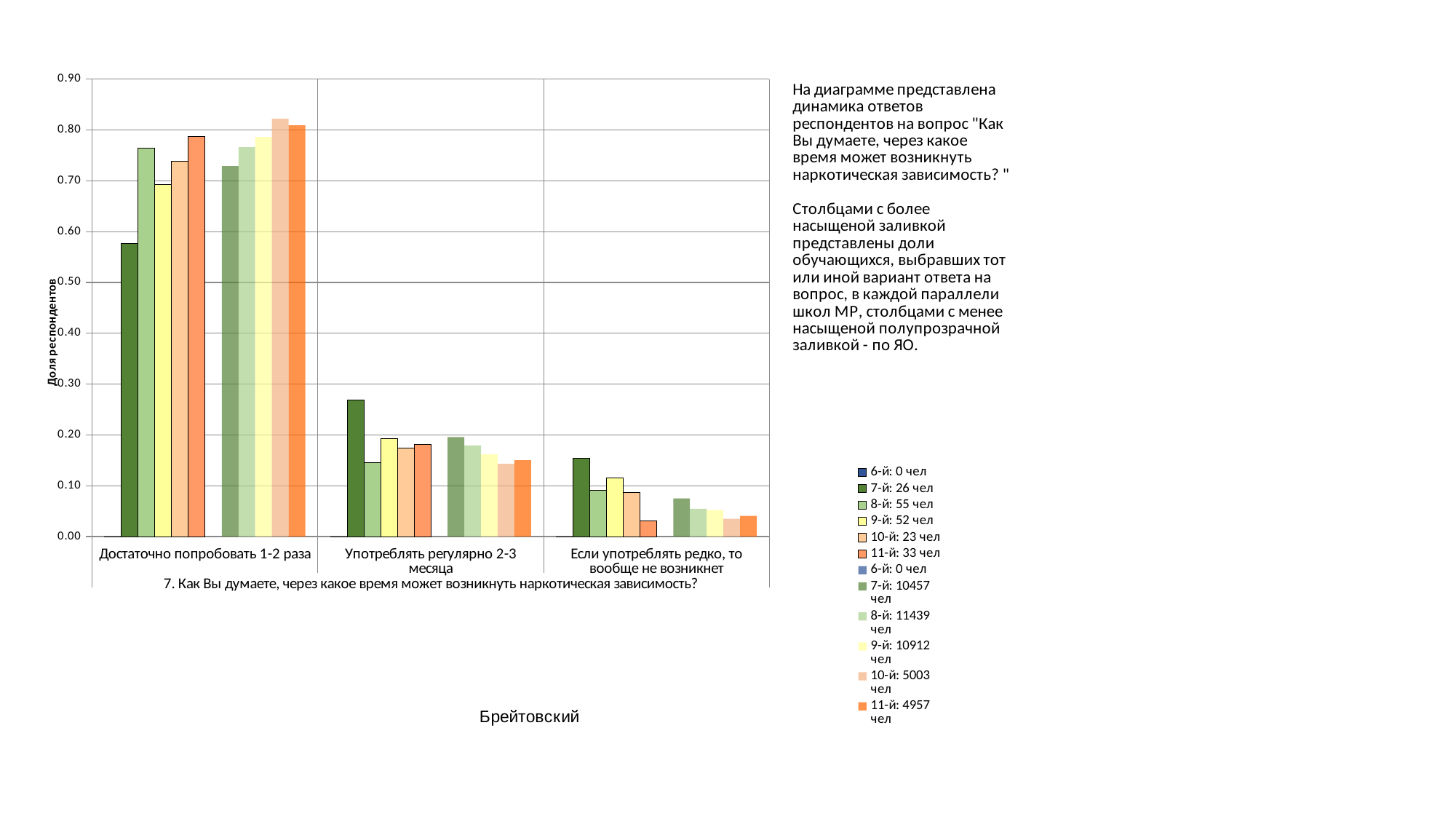
What kind of chart is shown on the slide? bar chart What is the label of the vertical axis of the chart? Доля респондентов Which answer category has the tallest bars in the chart? Достаточно попробовать 1-2 раза Is the value for '11-й: 33 чел' in the category 'Если употреблять редко, то вообще не возникнет' greater or less than 0.10? less Is the value for '7-й: 26 чел' in the category 'Достаточно попробовать 1-2 раза' greater or less than 0.50? greater In the category 'Достаточно попробовать 1-2 раза', which is larger: the value for '7-й: 26 чел' or for '8-й: 55 чел'? 8-й: 55 чел Is the value for '7-й: 26 чел' in the category 'Употреблять регулярно 2-3 месяца' greater or less than 0.20? greater Which answer category has the shortest bars in the chart? Если употреблять редко, то вообще не возникнет How many series does the chart legend list? 12 How many answer categories are shown on the x axis of the chart? 3 Do the values for '11-й: 33 чел' rise or fall across the categories from left to right? fall